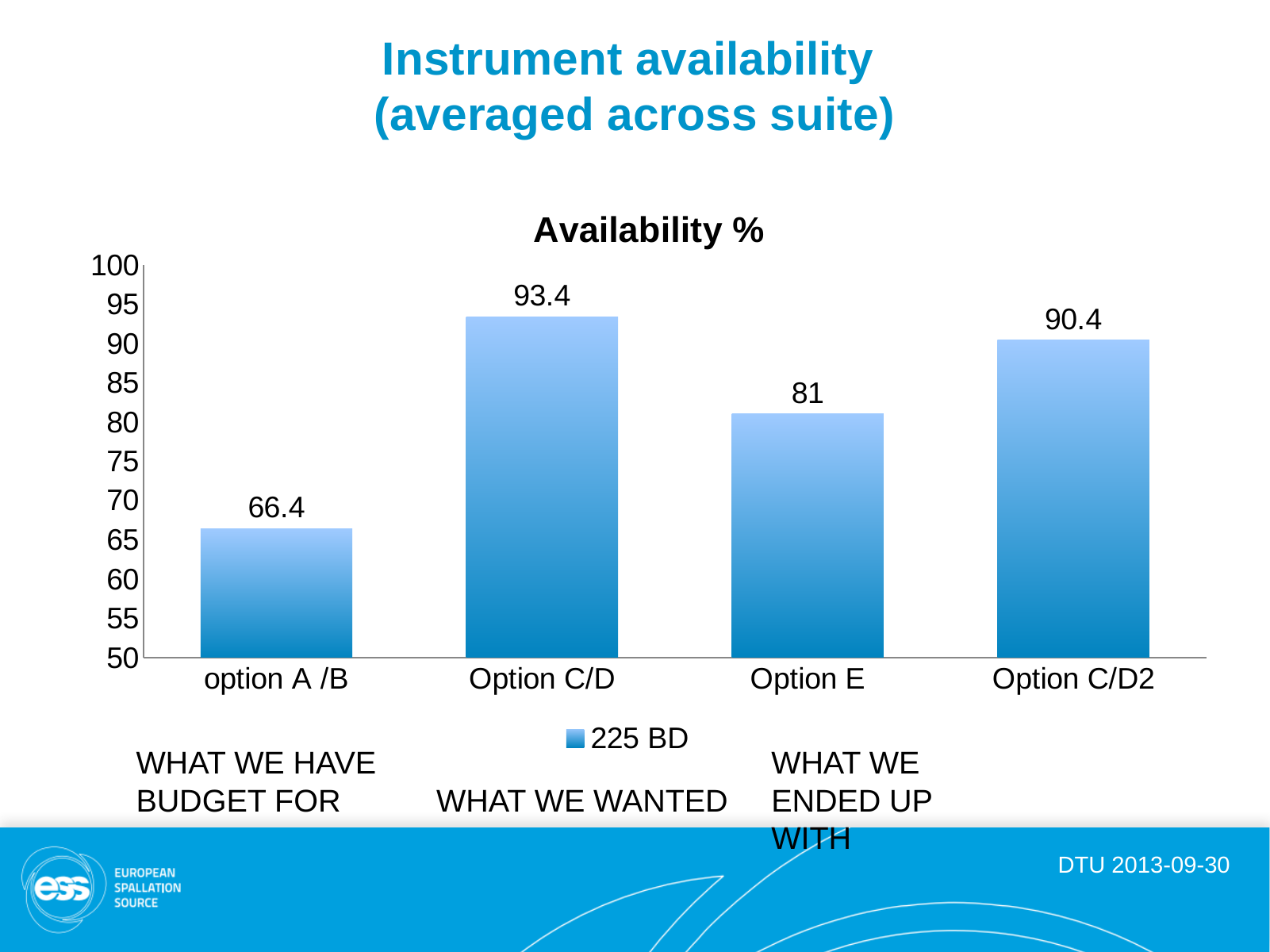
What is the difference in availability between Option C/D and option A /B? 27 What is the availability value for Option C/D2? 90.4 Which option has the lowest availability? option A /B What is the availability value for Option C/D? 93.4 How many options are shown on the chart? 4 Which has a higher availability, Option E or Option C/D2? Option C/D2 What is the availability value for option A /B? 66.4 What is the availability value for Option E? 81 Is the value for Option E greater or less than 75? greater What is the series name shown in the legend? 225 BD What type of chart is shown on the slide? bar chart Which option has the highest availability? Option C/D